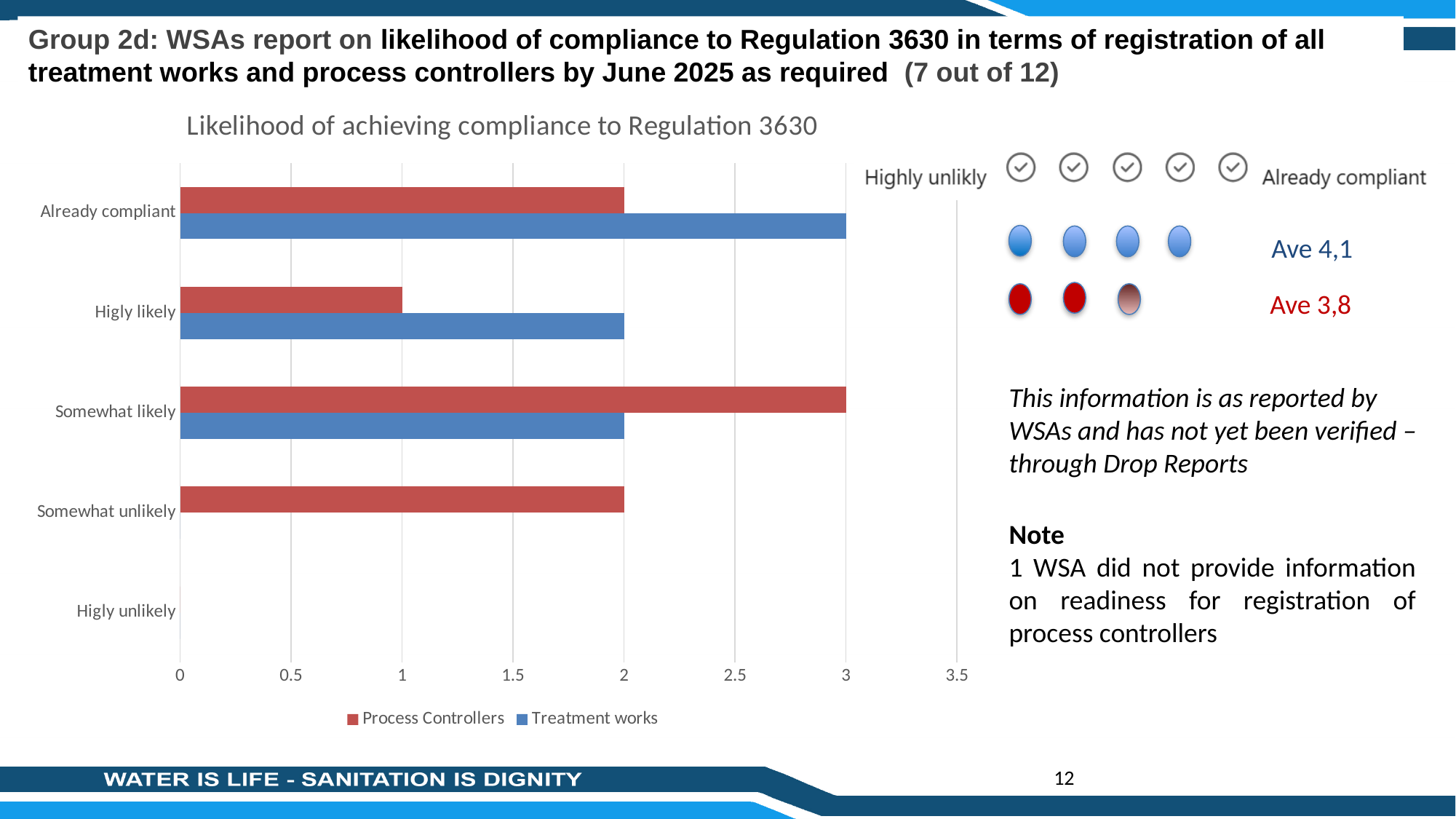
What is the title of the chart? Likelihood of achieving compliance to Regulation 3630 For Already compliant, which series has the larger value, Process Controllers or Treatment works? Treatment works What is the Process Controllers value for Higly likely? 1 What is the Treatment works value for Already compliant? 3 Which colour represents the Process Controllers series in the chart? Red What is the Process Controllers value for Somewhat likely? 3 How many series does the chart legend list? 2 How many categories are shown on the vertical axis of the chart? 5 Which category has the highest Process Controllers value? Somewhat likely What is the difference between the Process Controllers and Treatment works values for Somewhat likely? 1 What kind of chart is shown on the slide? Bar chart Which category has the highest Treatment works value? Already compliant